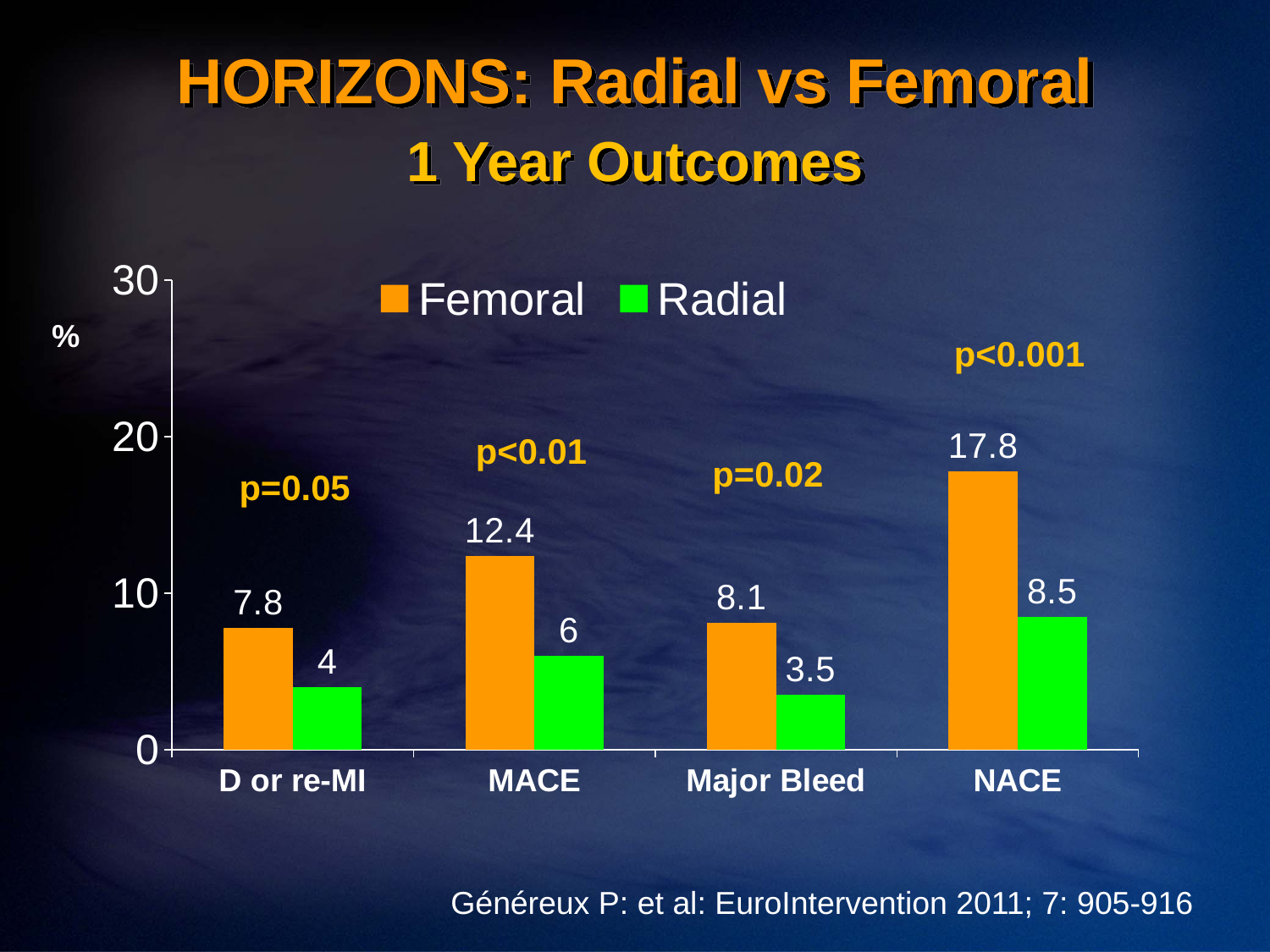
How many series does the legend list? 2 How many categories are shown on the x axis? 4 What is the Radial value for Major Bleed? 3.5 What is the difference between the Femoral and Radial values for NACE? 9.3 What is the difference between the Femoral and Radial values for MACE? 6.4 What kind of chart is shown on the slide? Bar chart What is the Femoral value for D or re-MI? 7.8 Which category has the highest Femoral value? NACE Which category has the lowest Radial value? Major Bleed Which is larger, the Femoral value for Major Bleed or the Radial value for NACE? Radial value for NACE What is the Femoral value for MACE? 12.4 What is the Radial value for NACE? 8.5